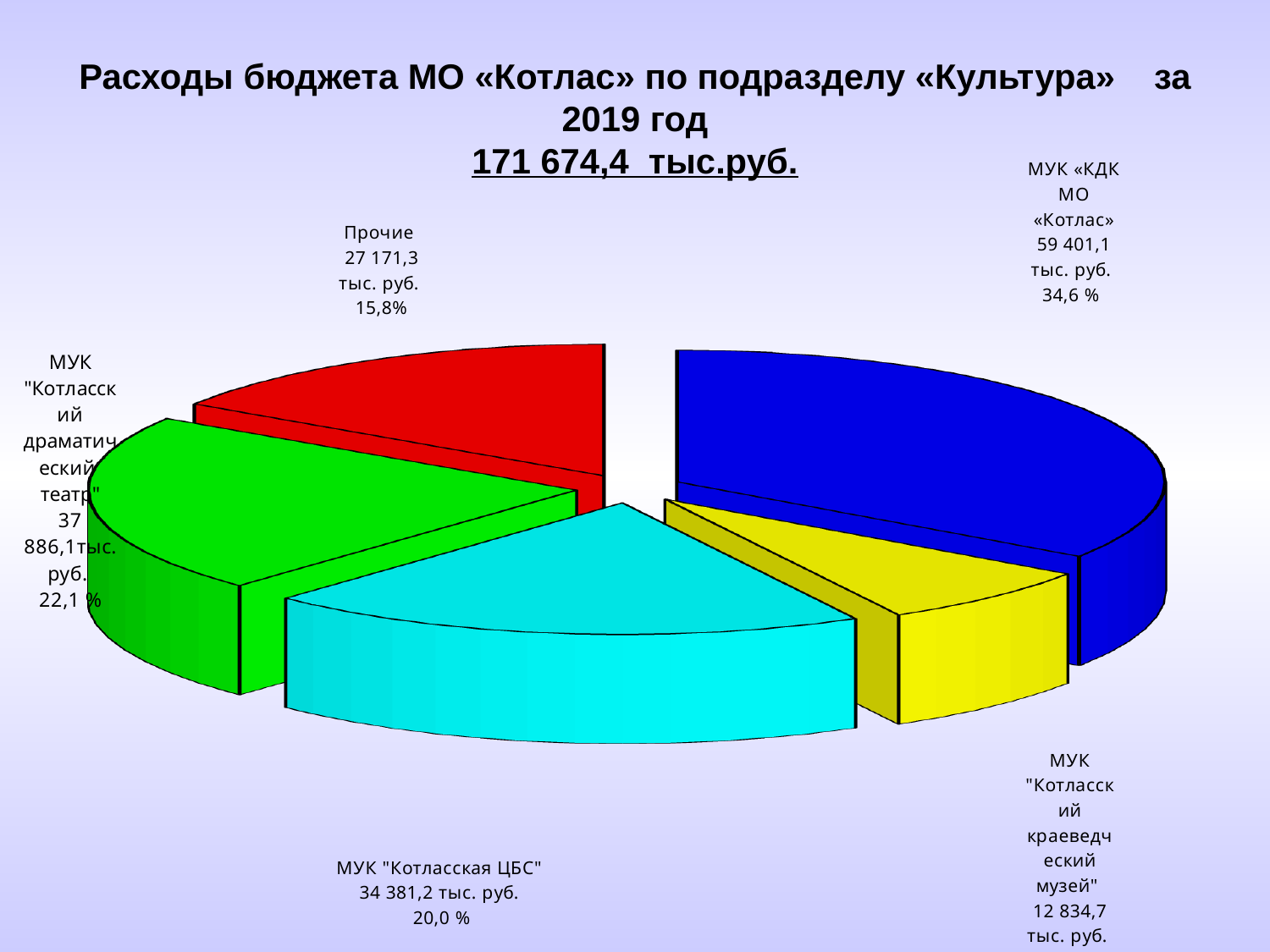
What is the value for Прочие? 27 171,3 тыс. руб. What share of the pie does МУК «КДК МО «Котлас» account for? 34,6 % Which is larger: МУК "Котласский драматический театр" or МУК "Котласская ЦБС"? МУК "Котласский драматический театр" Which category has the smallest slice of the pie? МУК "Котласский краеведческий музей" What total amount is stated in the chart title? 171 674,4 тыс.руб. Which category has the largest slice of the pie? МУК «КДК МО «Котлас» What is the value for МУК "Котласский краеведческий музей"? 12 834,7 тыс. руб. What kind of chart is shown on the slide? pie chart What percentage of the pie is МУК "Котласский драматический театр"? 22,1 % How many slices does the pie chart have? 5 What is the value for МУК «КДК МО «Котлас» in the pie chart? 59 401,1 тыс. руб. What is the value for МУК "Котласская ЦБС"? 34 381,2 тыс. руб.